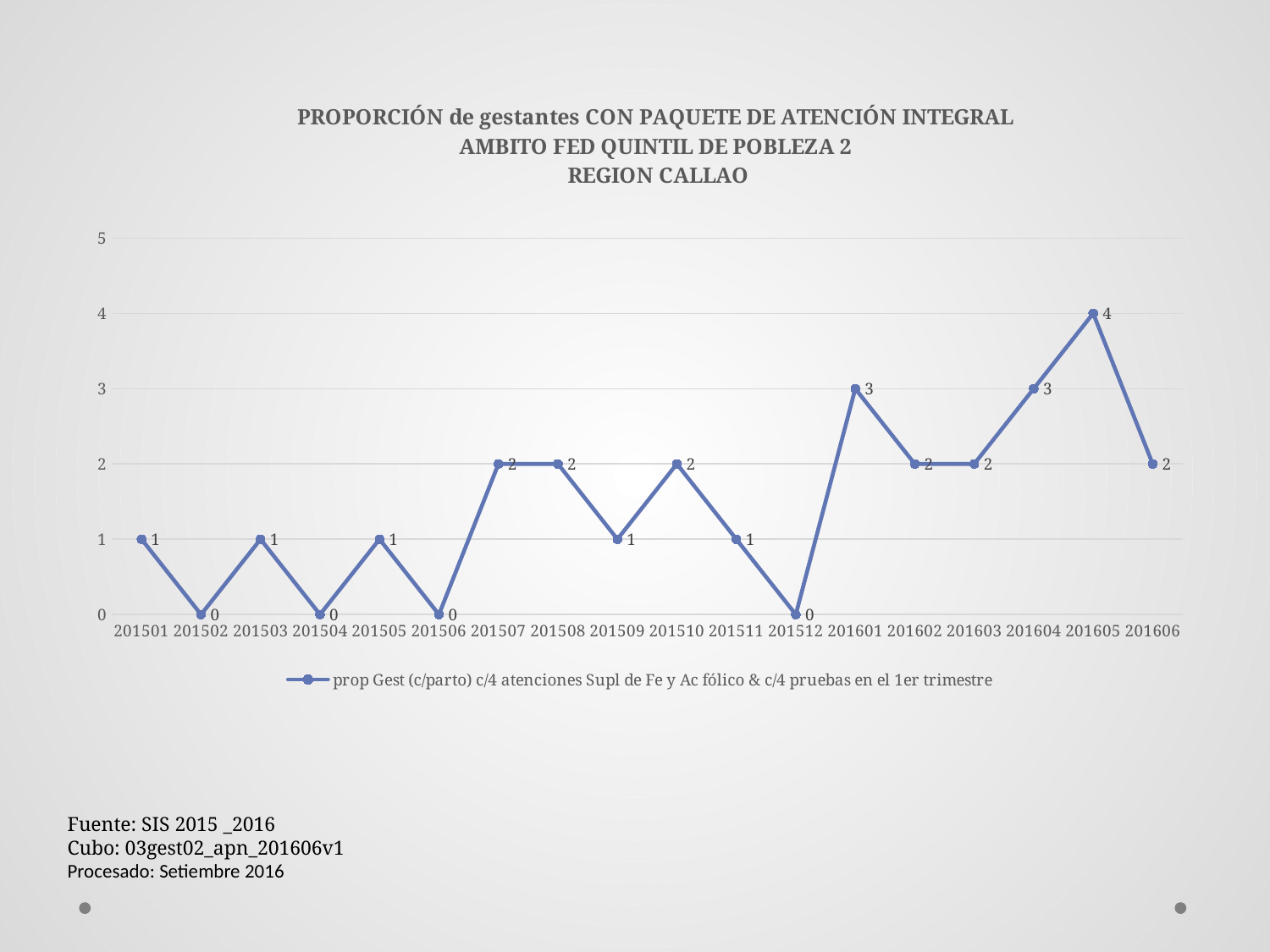
How many periods are plotted on the x axis? 18 What is the difference between the values for 201605 and 201606? 2 How many periods have a value of 0? 4 Do the values generally rise or fall from 201512 to 201605? rise What is the value for 201605? 4 Which is larger, the value for 201604 or the value for 201509? 201604 How many series does the legend list? 1 Which region is named in the chart title? REGION CALLAO What is the value for 201601? 3 What is the value for 201512? 0 Which period has the highest value? 201605 What kind of chart is shown? line chart